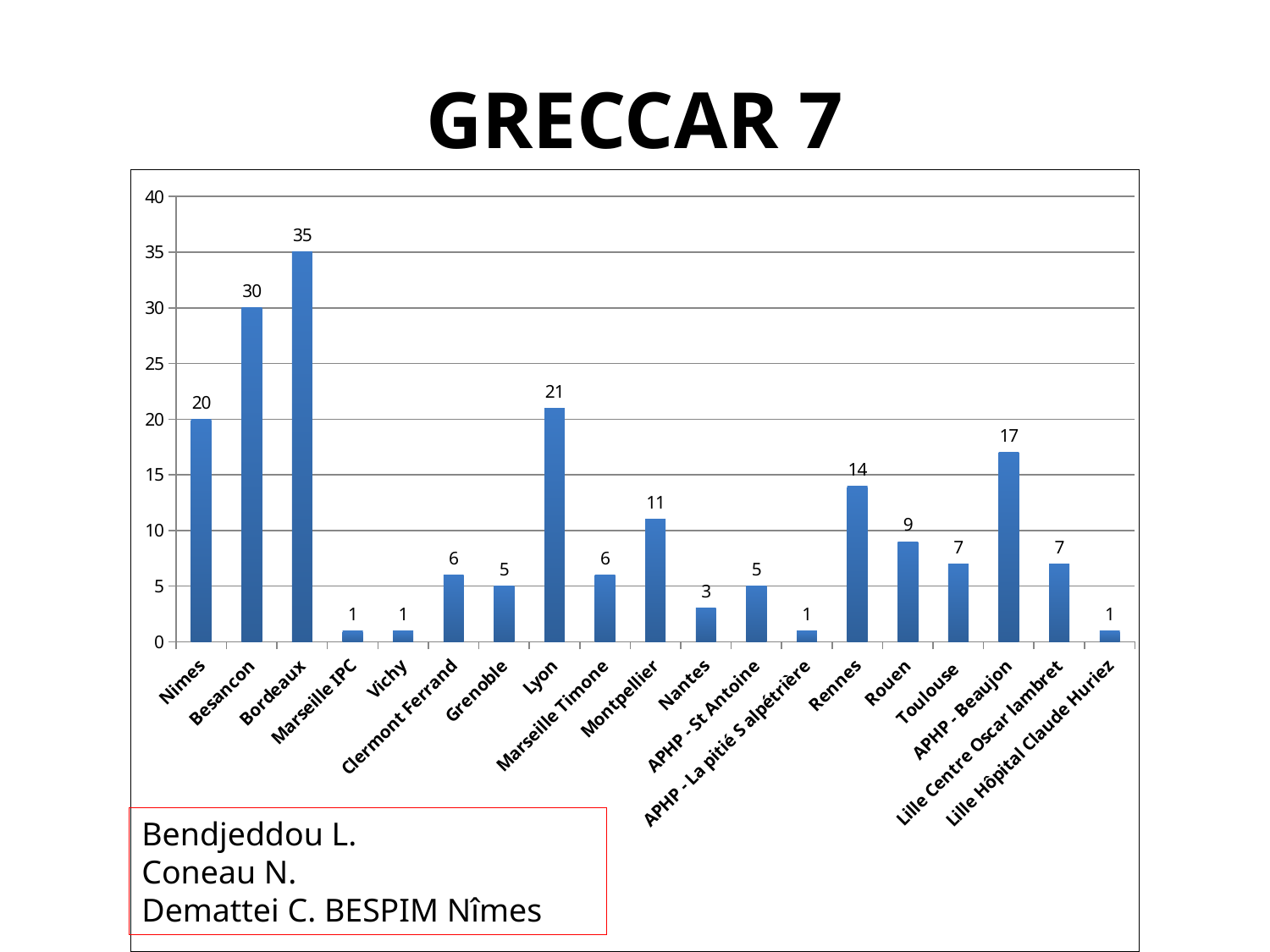
What kind of chart is shown on the slide? bar chart What is the value for Lyon? 21 What is the title of the slide containing the chart? GRECCAR 7 What is the value for APHP - Beaujon? 17 What is the difference between the values for Besancon and Nimes? 10 What is the value for Rennes? 14 Is the value for Besancon greater or less than 25? greater Which category has the highest value? Bordeaux What is the value for Bordeaux? 35 What is the difference between the values for Montpellier and Rouen? 2 How many categories are shown on the x axis? 19 Which is larger, the value for Lyon or the value for Rennes? Lyon